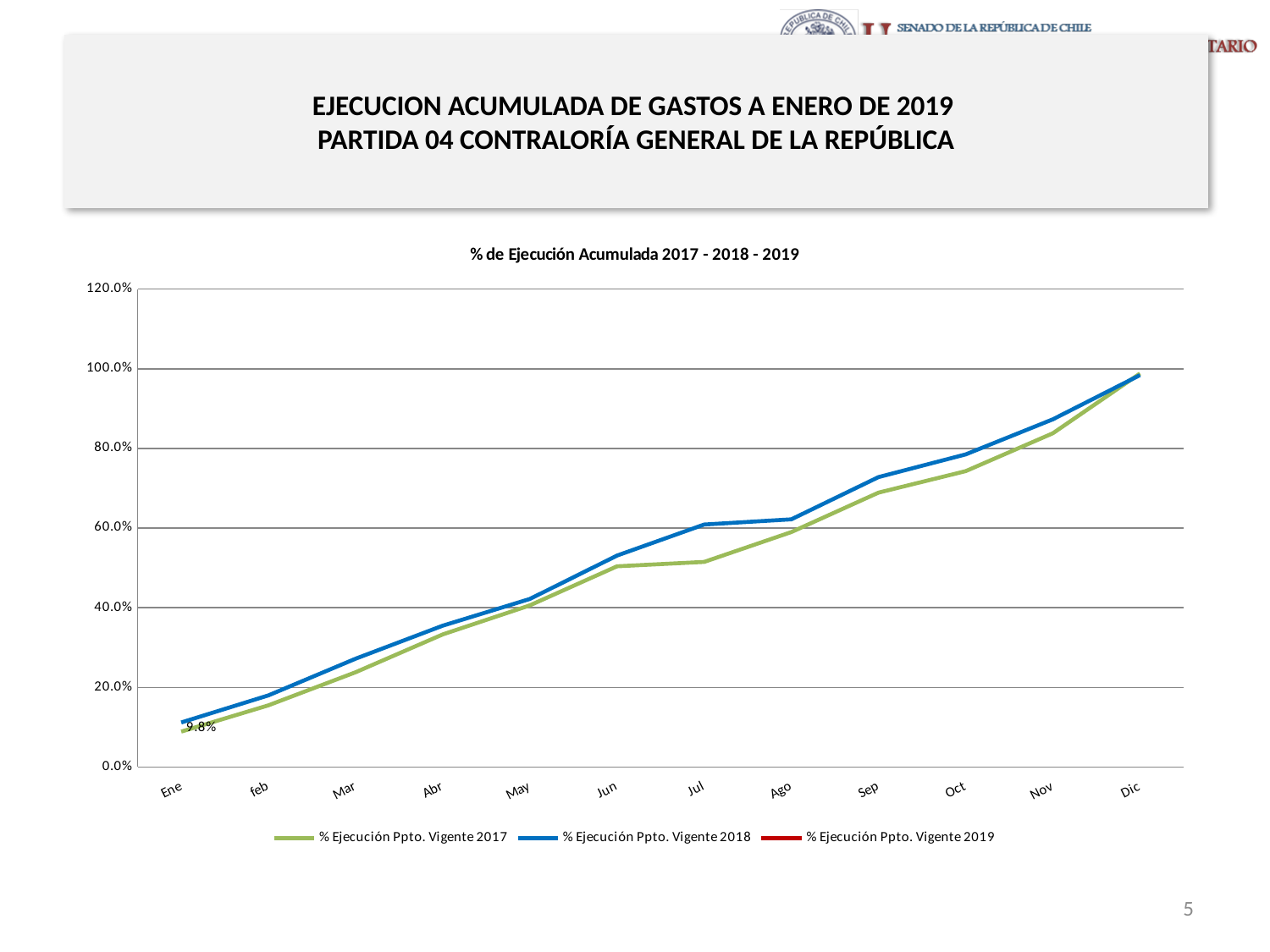
How many months are shown along the x axis of the chart? 12 In Jul, which series has the higher value, % Ejecución Ppto. Vigente 2017 or % Ejecución Ppto. Vigente 2018? % Ejecución Ppto. Vigente 2018 Is the value for % Ejecución Ppto. Vigente 2018 in Sep greater or less than 60.0%? greater Do the values of the % Ejecución Ppto. Vigente 2018 line rise or fall from Ene to Dic? rise What is the title of the chart? % de Ejecución Acumulada 2017 - 2018 - 2019 In which month does the % Ejecución Ppto. Vigente 2017 line reach its lowest value? Ene What data label value is printed on the chart at Ene? 9.8% Is the value for % Ejecución Ppto. Vigente 2017 in Oct greater or less than 80.0%? less Is the value for % Ejecución Ppto. Vigente 2018 in Mar greater or less than 20.0%? greater How many series does the chart legend list? 3 What kind of chart is shown on the slide? line chart